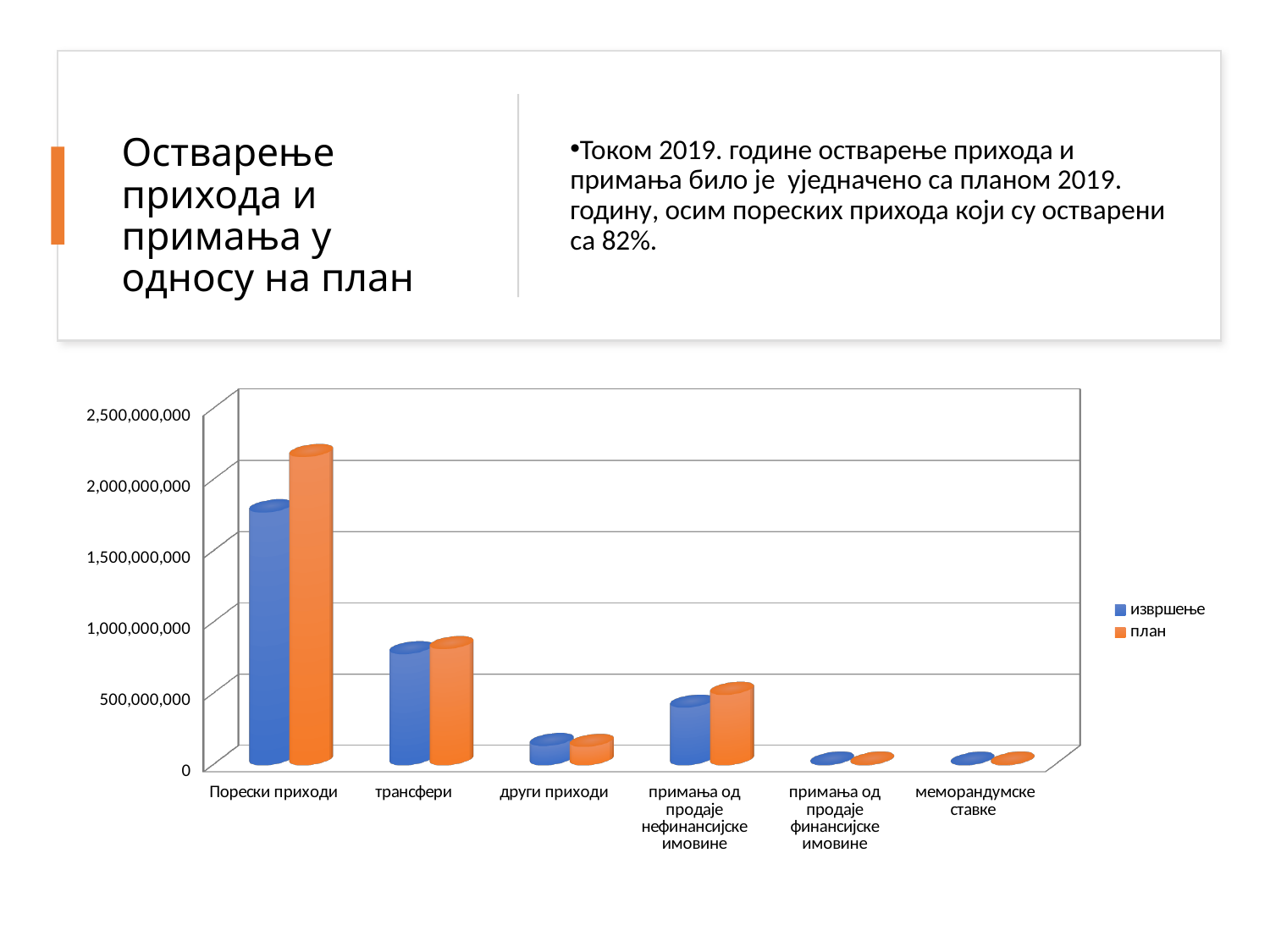
Which series is shown in orange in the chart? план Which category has the highest план value? Порески приходи Which series is shown in blue in the chart? извршење How many series does the chart legend list? 2 For Порески приходи, which is larger: извршење or план? план Which category has the highest извршење value? Порески приходи Is the план value for други приходи greater or less than 500,000,000? less What kind of chart is shown on the slide? bar chart Is the план value for Порески приходи greater or less than 2,000,000,000? greater Is the извршење value for Порески приходи greater or less than 1,500,000,000? greater How many categories are shown on the x axis of the chart? 6